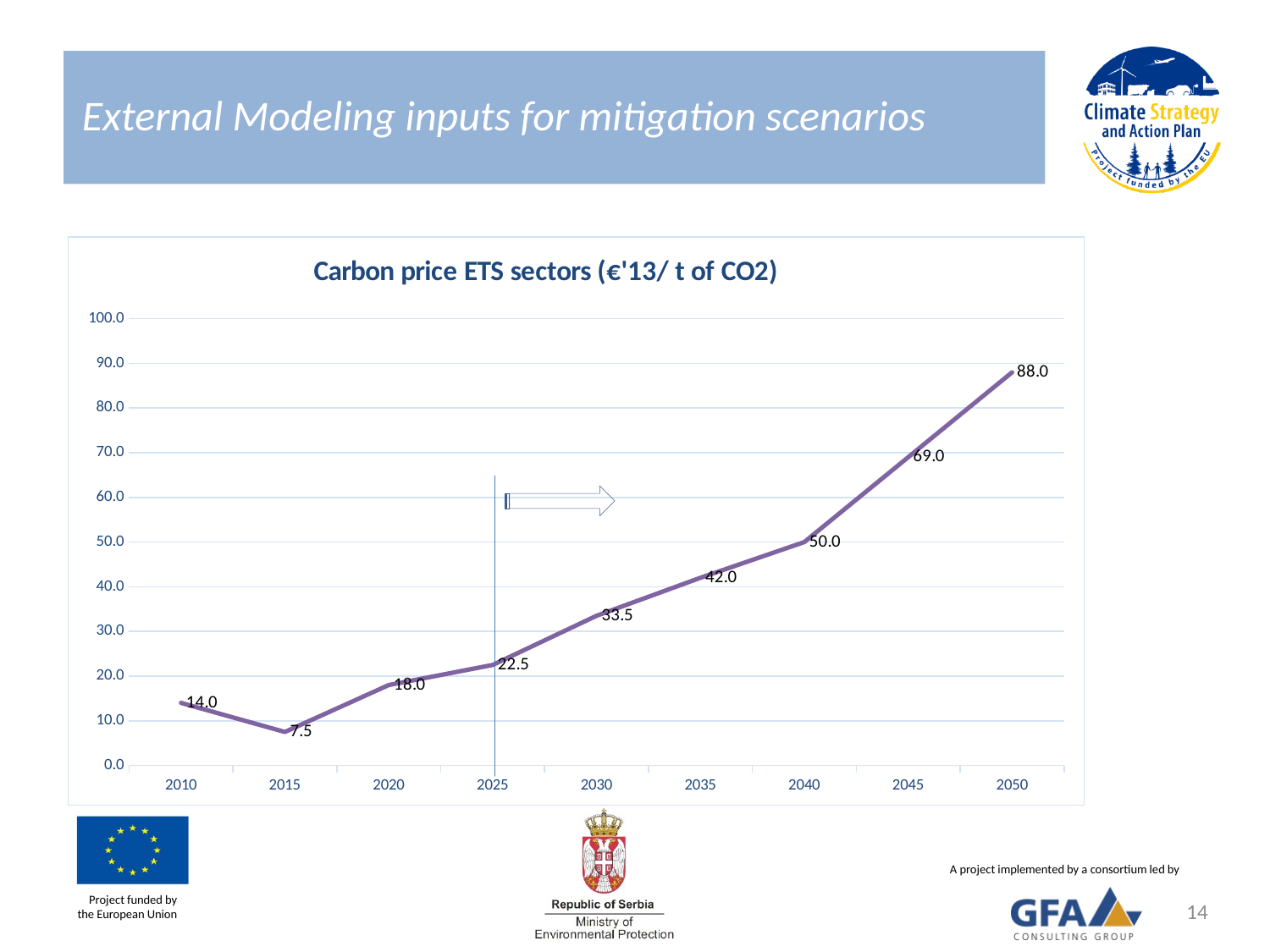
What is the difference between the carbon price in 2025 and in 2020? 4.5 What is the carbon price shown for 2045? 69.0 What is the carbon price shown for 2015? 7.5 What is the title of the chart? Carbon price ETS sectors (€'13/ t of CO2) How many years are plotted on the x axis? 9 Which year has the highest carbon price? 2050 Which year has a higher carbon price, 2010 or 2020? 2020 What is the difference between the carbon price in 2050 and in 2040? 38.0 What type of chart is shown on the slide? line chart Which year has the lowest carbon price? 2015 What is the carbon price shown for 2030? 33.5 Does the carbon price rise or fall between 2015 and 2050? rise